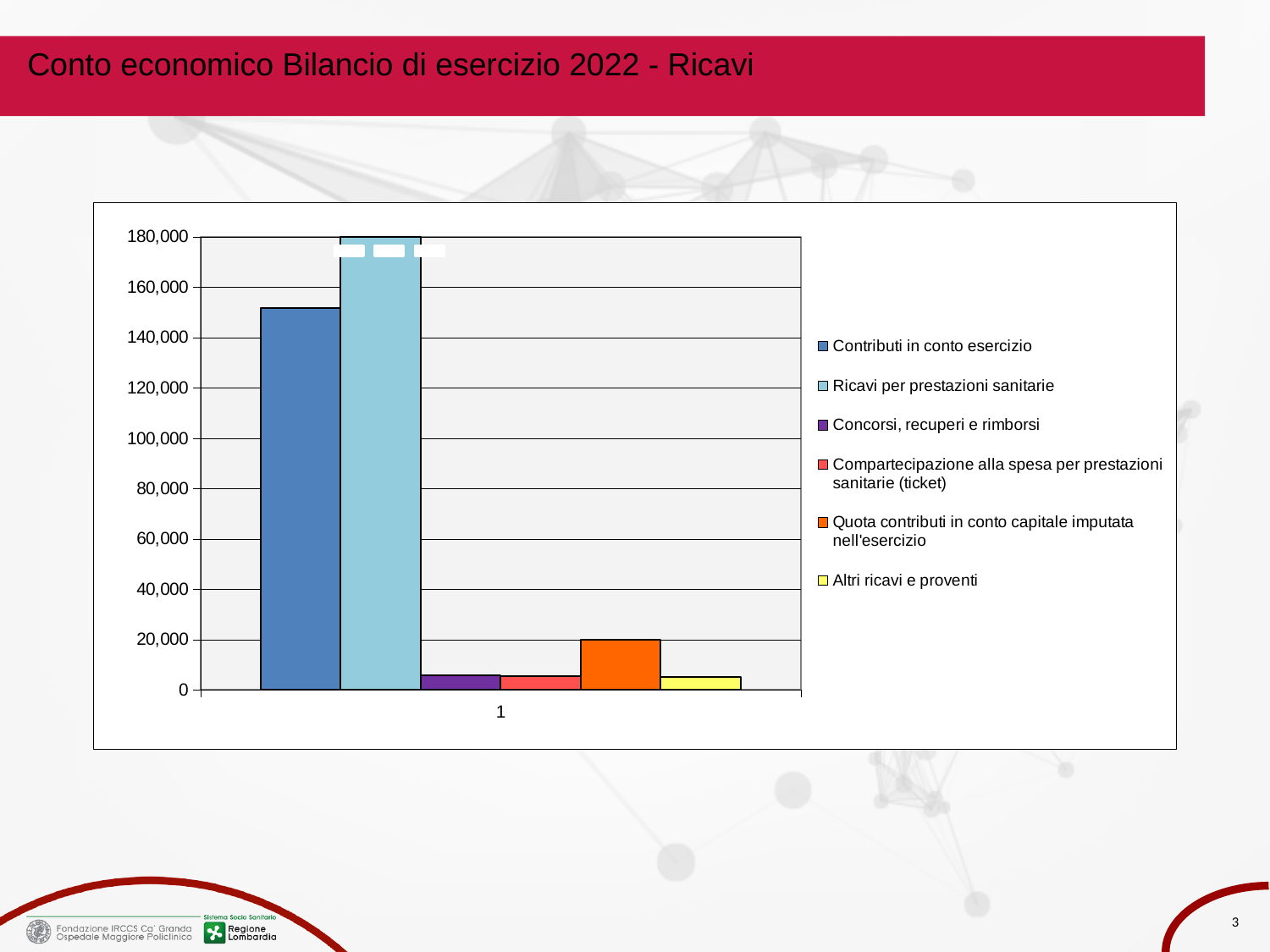
Is the value for Concorsi, recuperi e rimborsi greater or less than 20,000? less Is the value for Contributi in conto esercizio greater or less than 160,000? less Which is larger, Contributi in conto esercizio or Ricavi per prestazioni sanitarie? Ricavi per prestazioni sanitarie Is the value for Contributi in conto esercizio greater or less than 140,000? greater What kind of chart is shown on the slide? bar chart How many series does the legend list? 6 What colour is the bar for Altri ricavi e proventi? yellow Which series has the highest bar? Ricavi per prestazioni sanitarie What is the title of the slide containing the chart? Conto economico Bilancio di esercizio 2022 - Ricavi Which is larger, Quota contributi in conto capitale imputata nell'esercizio or Concorsi, recuperi e rimborsi? Quota contributi in conto capitale imputata nell'esercizio